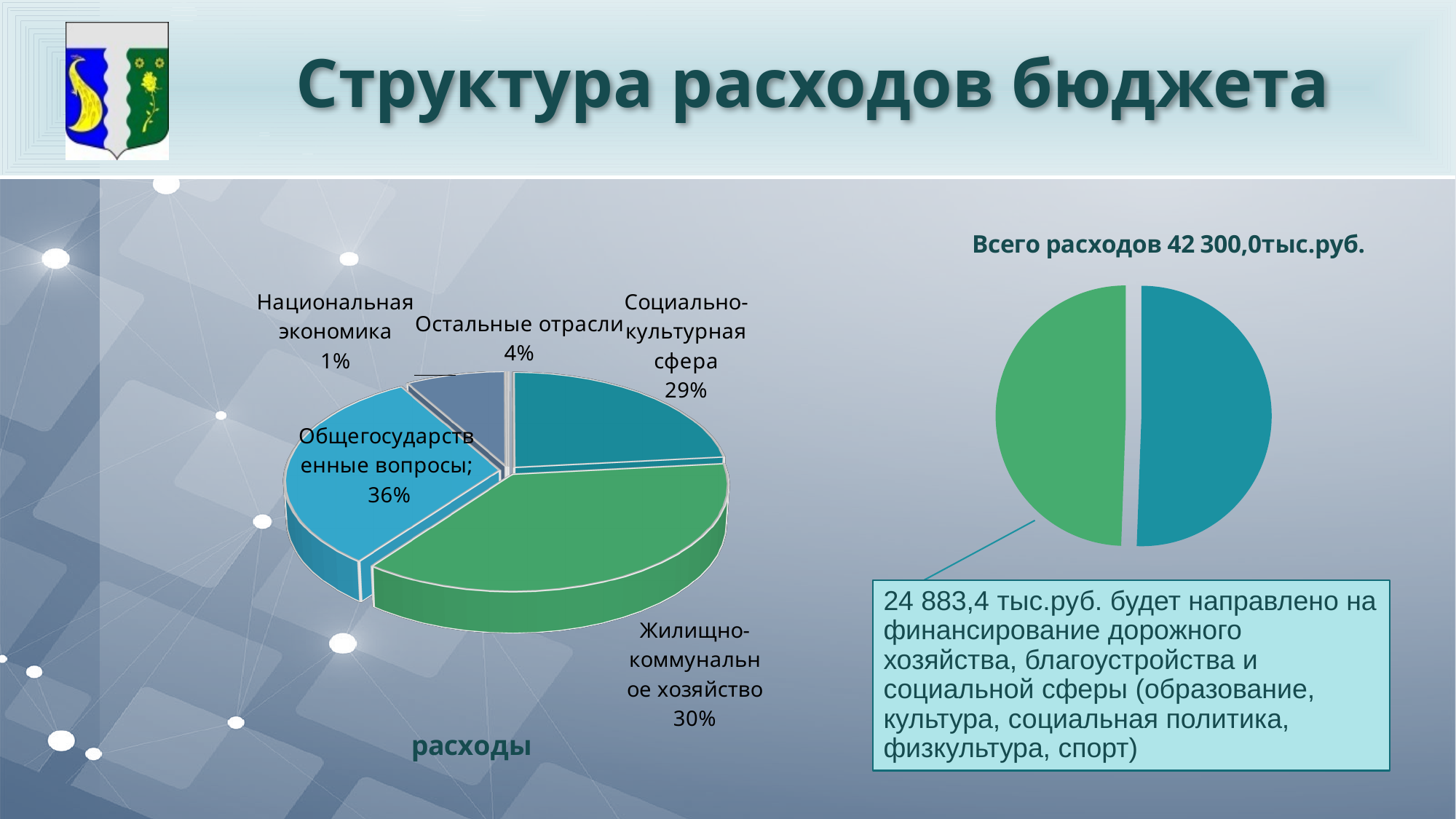
How many slices does the small pie chart on the right of the slide have? 2 What type of chart is the chart on the left of the slide? Pie chart On the left pie chart titled "расходы", which category has the smallest share? Национальная экономика On the left pie chart titled "расходы", what share is labelled for Национальная экономика? 1% On the left pie chart titled "расходы", which category has the largest share? Общегосударственные вопросы On the left pie chart titled "расходы", what is the difference in percentage points between Общегосударственные вопросы and Жилищно-коммунальное хозяйство? 6 On the left pie chart titled "расходы", which is larger: Социально-культурная сфера or Остальные отрасли? Социально-культурная сфера On the left pie chart titled "расходы", what share is labelled for Жилищно-коммунальное хозяйство? 30% On the left pie chart titled "расходы", what share is labelled for Социально-культурная сфера? 29% On the left pie chart titled "расходы", what share is labelled for Остальные отрасли? 4% On the left pie chart titled "расходы", what share is labelled for Общегосударственные вопросы? 36% How many slices does the left pie chart titled "расходы" have? 5